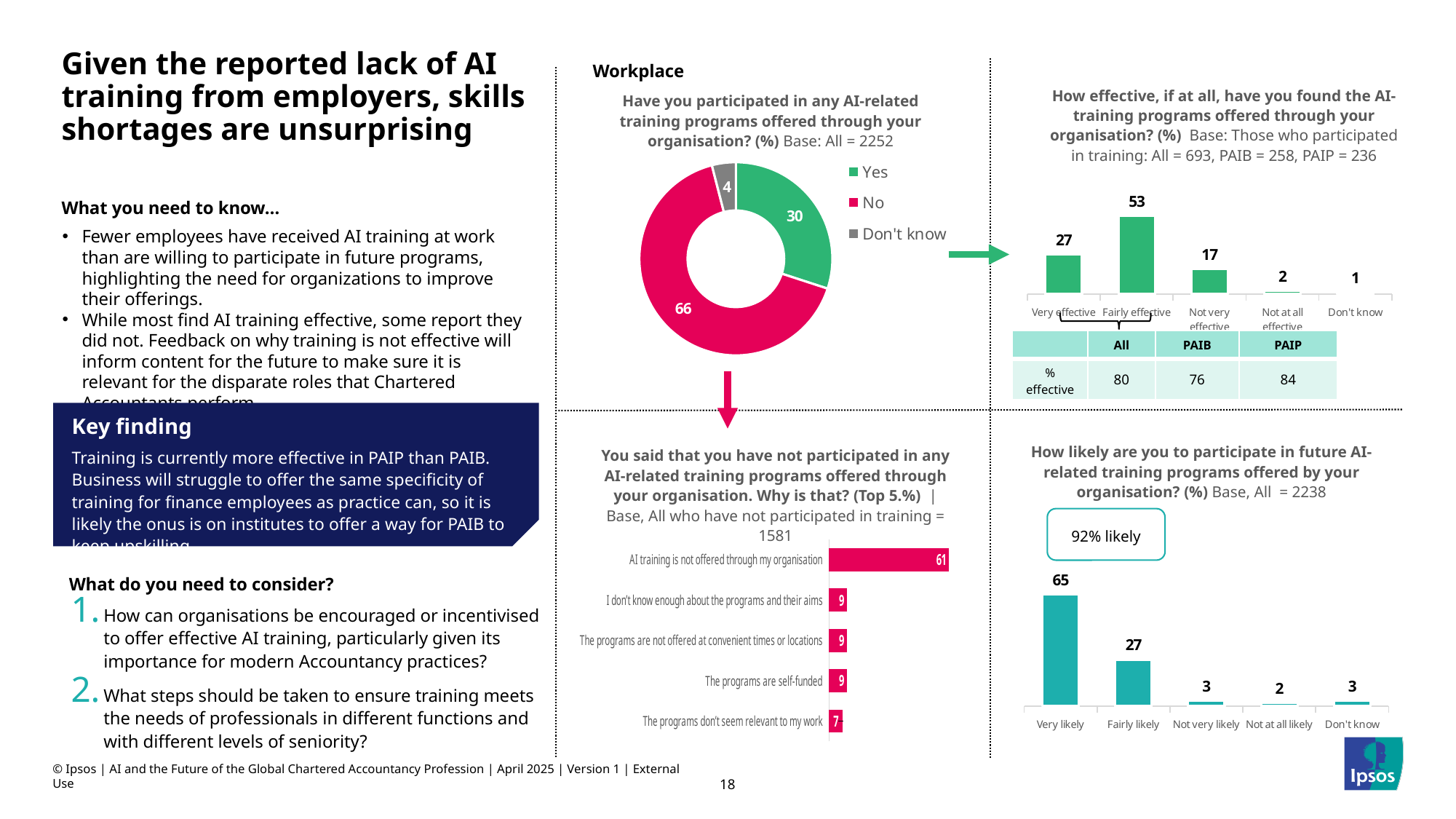
How many entries does the legend of the donut chart 'Have you participated in any AI-related training programs offered through your organisation?' list? 3 In the chart 'How likely are you to participate in future AI-related training programs offered by your organisation?', what is the difference between Very likely and Fairly likely? 38 In the chart 'How likely are you to participate in future AI-related training programs offered by your organisation?', which is larger: Fairly likely or Not very likely? Fairly likely In the donut chart 'Have you participated in any AI-related training programs offered through your organisation?', what percentage answered Yes? 30 In the donut chart 'Have you participated in any AI-related training programs offered through your organisation?', which response has the largest share? No In the chart 'How effective, if at all, have you found the AI-training programs offered through your organisation?', what is the value for Fairly effective? 53 In the chart 'How effective, if at all, have you found the AI-training programs offered through your organisation?', which category has the lowest value? Don't know In the chart 'You said that you have not participated in any AI-related training programs offered through your organisation. Why is that?', what is the value for 'AI training is not offered through my organisation'? 61 In the chart 'How effective, if at all, have you found the AI-training programs offered through your organisation?', what is the difference between Fairly effective and Very effective? 26 In the chart 'How likely are you to participate in future AI-related training programs offered by your organisation?', what is the value for Very likely? 65 How many categories are shown in the chart 'You said that you have not participated in any AI-related training programs offered through your organisation. Why is that?'? 5 What type of chart is 'You said that you have not participated in any AI-related training programs offered through your organisation. Why is that?'? Bar chart